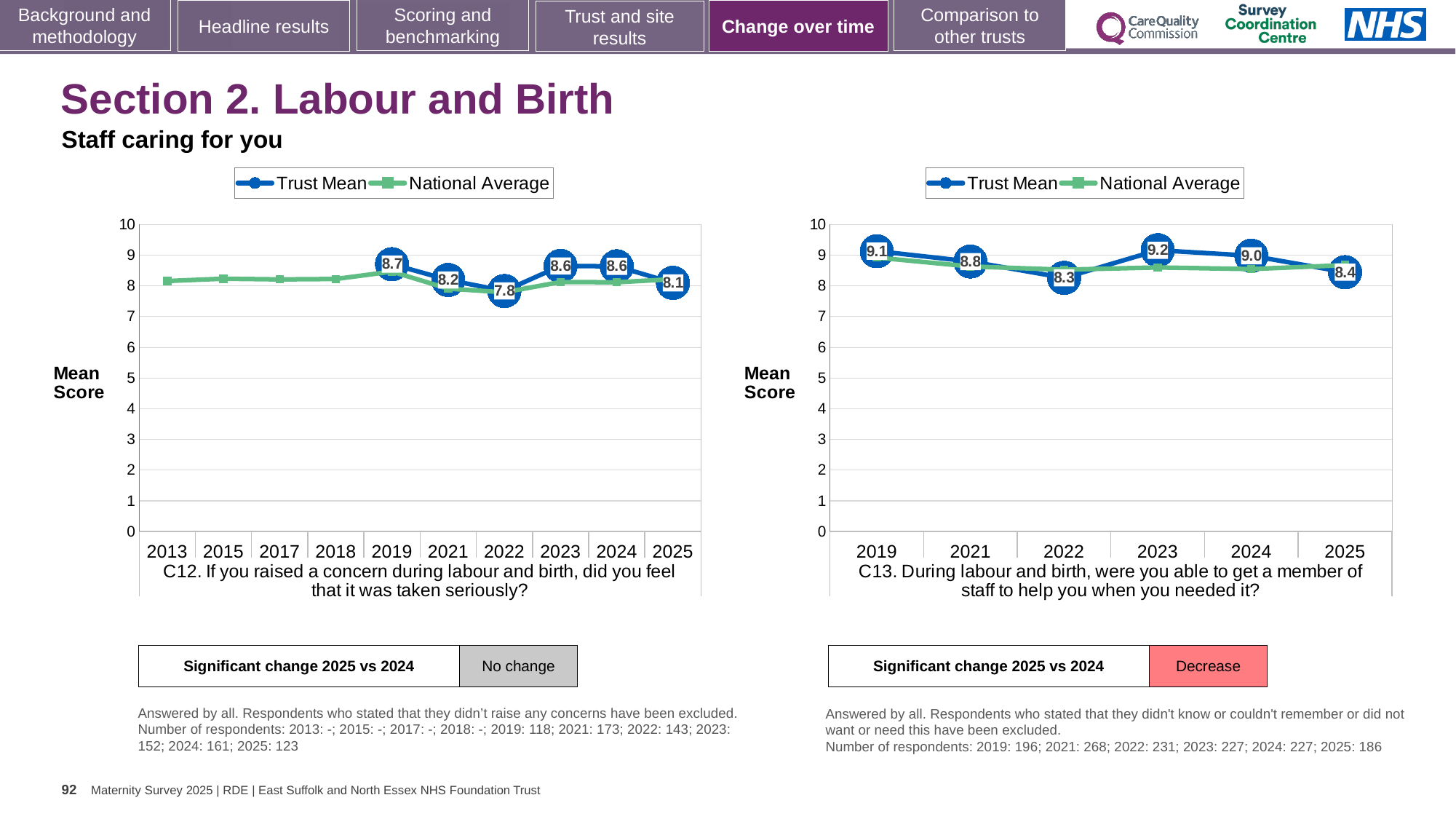
How many years are shown on the x axis of the C12 chart on the left? 10 In the C13 chart on the right, what is the difference between the Trust Mean for 2019 and 2022? 0.8 In the C13 chart on the right, what is the Trust Mean for 2023? 9.2 How many series does the legend of the C13 chart on the right list? 2 In the C13 chart on the right, which year has the highest Trust Mean? 2023 In the C12 chart on the left, is the Trust Mean higher in 2019 or in 2021? 2019 In the C12 chart on the left, what is the Trust Mean for 2022? 7.8 What kind of chart is the C12 chart on the left? Line chart In the C13 chart on the right, what is the Trust Mean for 2025? 8.4 In the C13 chart on the right, is the National Average for 2025 greater or less than 8? greater In the C12 chart on the left, what is the Trust Mean for 2025? 8.1 In the C12 chart on the left, which year has the lowest Trust Mean? 2022